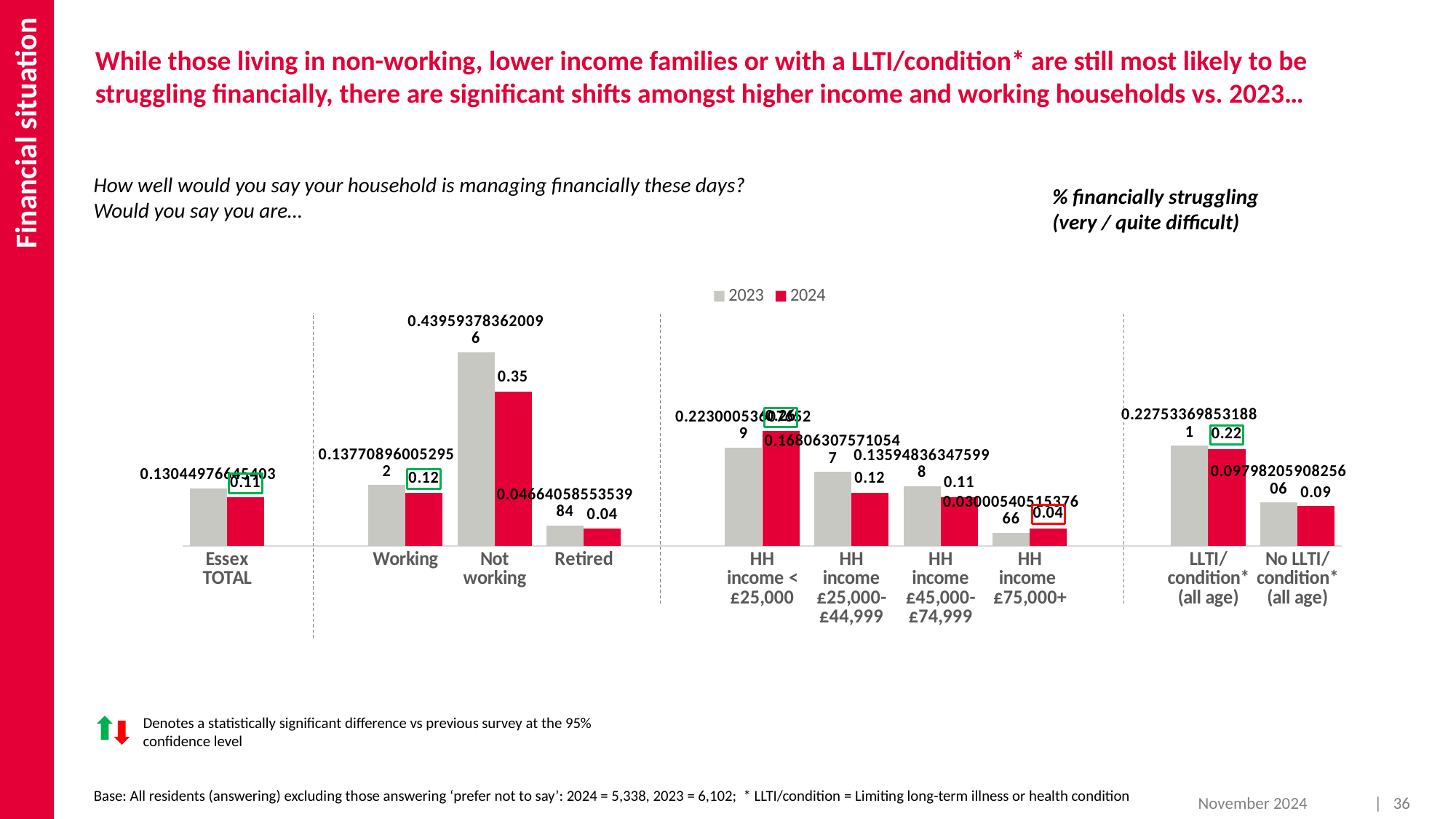
What is the 2024 value for Essex TOTAL? 0.11 What kind of chart is shown on the slide? Bar chart How many series does the legend list? 2 What is the 2024 value for Not working? 0.35 Which category has the highest 2024 value? Not working Which is larger in 2024: LLTI/condition* (all age) or No LLTI/condition* (all age)? LLTI/condition* (all age) What is the 2024 value for Retired? 0.04 Do the 2024 values rise or fall as household income increases from under £25,000 to £75,000+? Fall What is the 2024 value for LLTI/condition* (all age)? 0.22 How many categories are shown on the x axis? 10 What is the difference between the 2024 values for Not working and Working? 0.23 What is the 2024 value for HH income £25,000-£44,999? 0.12